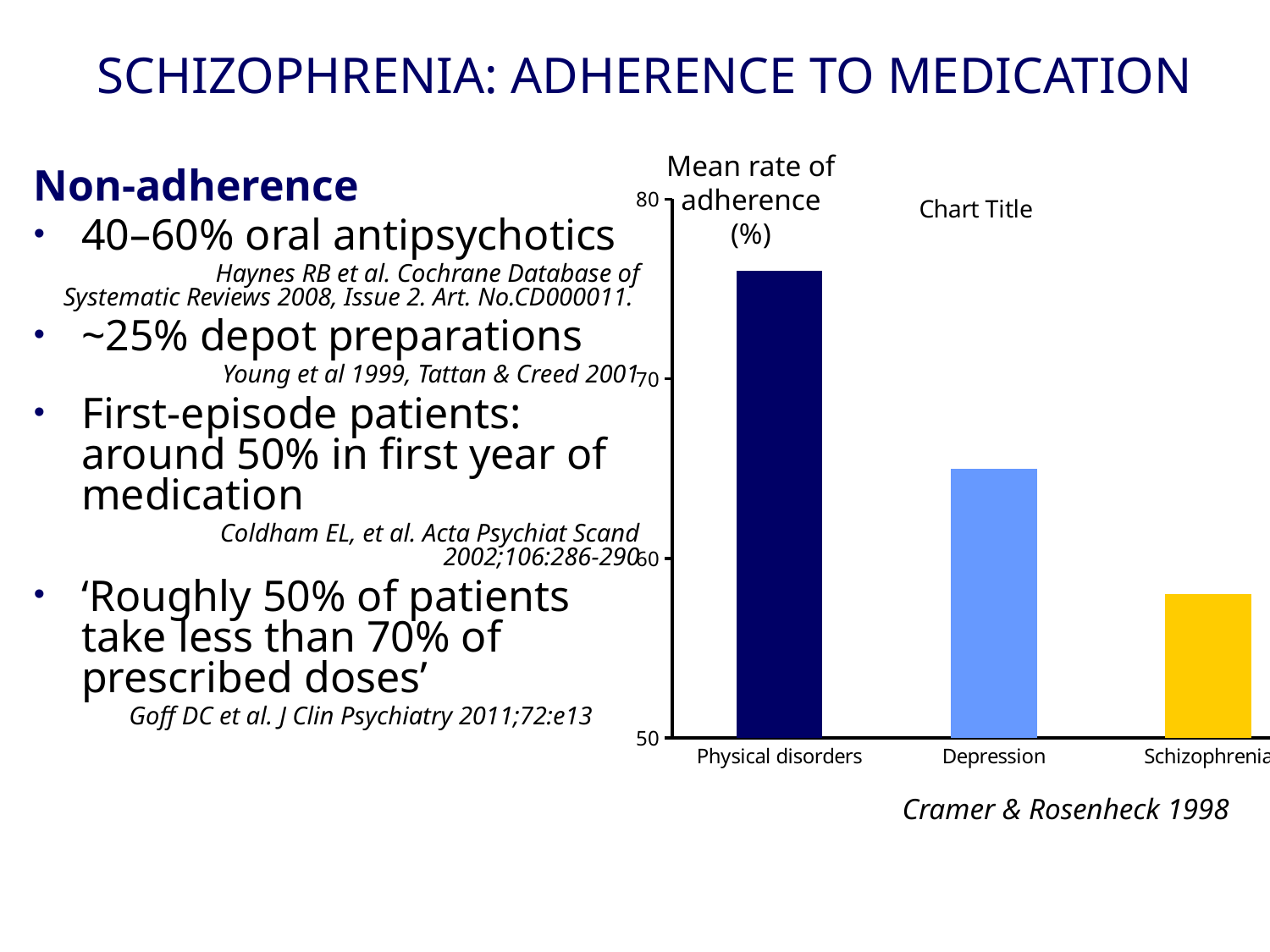
Is the value for Depression greater or less than 70? less Which has a higher mean rate of adherence, Physical disorders or Depression? Physical disorders Do the bar values rise or fall from left to right across the x axis? fall What colour is the bar for Schizophrenia? yellow Is the value for Physical disorders greater or less than 70? greater Which category has the highest mean rate of adherence? Physical disorders Which has a higher mean rate of adherence, Depression or Schizophrenia? Depression What is the label on the vertical axis of the chart? Mean rate of adherence (%) Is the value for Schizophrenia greater or less than 60? less How many categories are plotted on the x axis of the chart? 3 What kind of chart is shown on the slide? bar chart Which category has the lowest mean rate of adherence? Schizophrenia